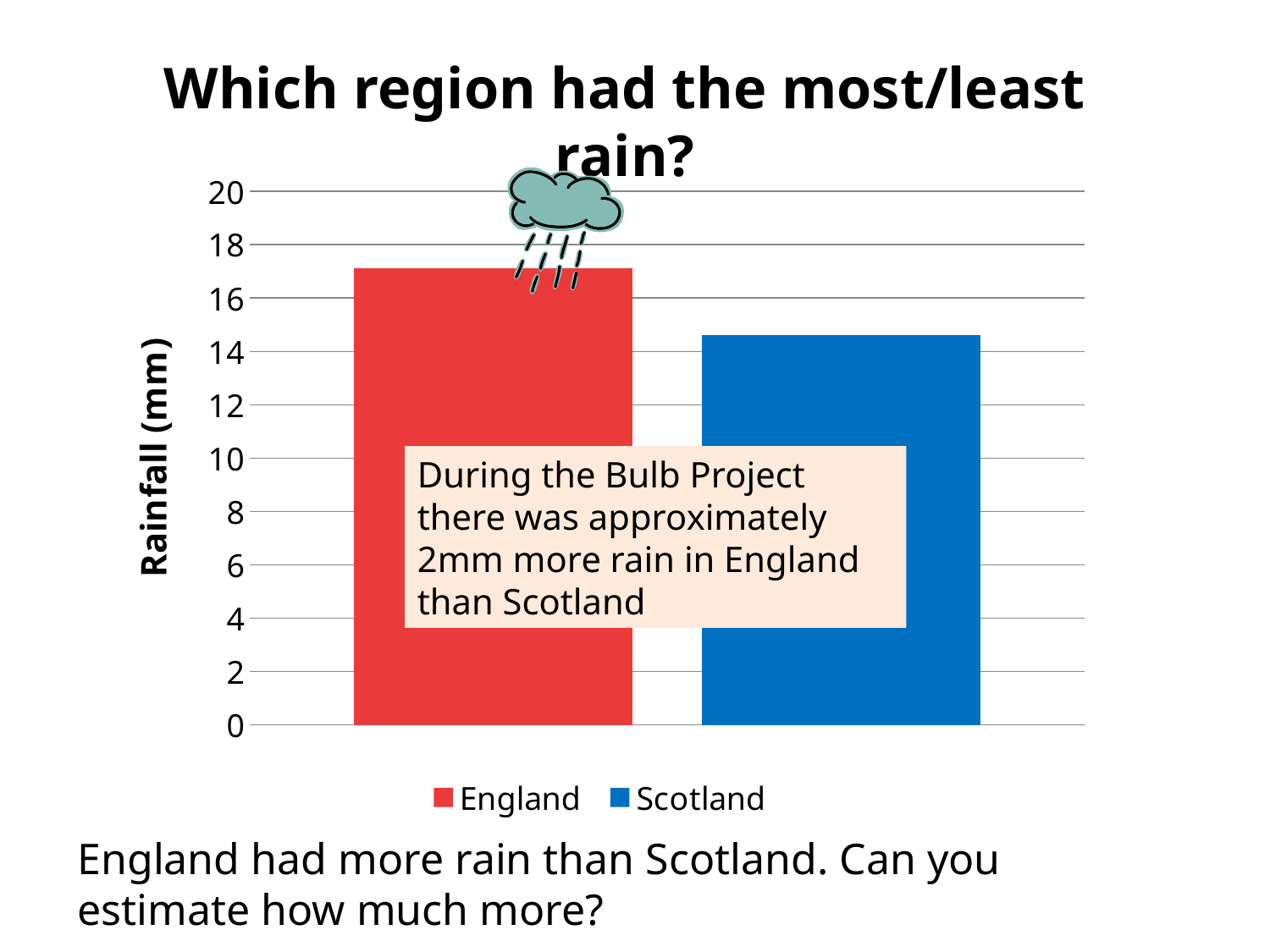
How many series does the legend list? 2 Which region had the most rainfall? England Is the rainfall value for England greater or less than 18? less Which is larger, the rainfall for England or for Scotland? England What kind of chart is shown on the slide? bar chart What is the label on the vertical axis? Rainfall (mm) Is the rainfall value for Scotland greater or less than 14? greater What colour is the bar for Scotland? blue How many bars are plotted on the chart? 2 Which region had the least rainfall? Scotland Is the rainfall value for England greater or less than 16? greater